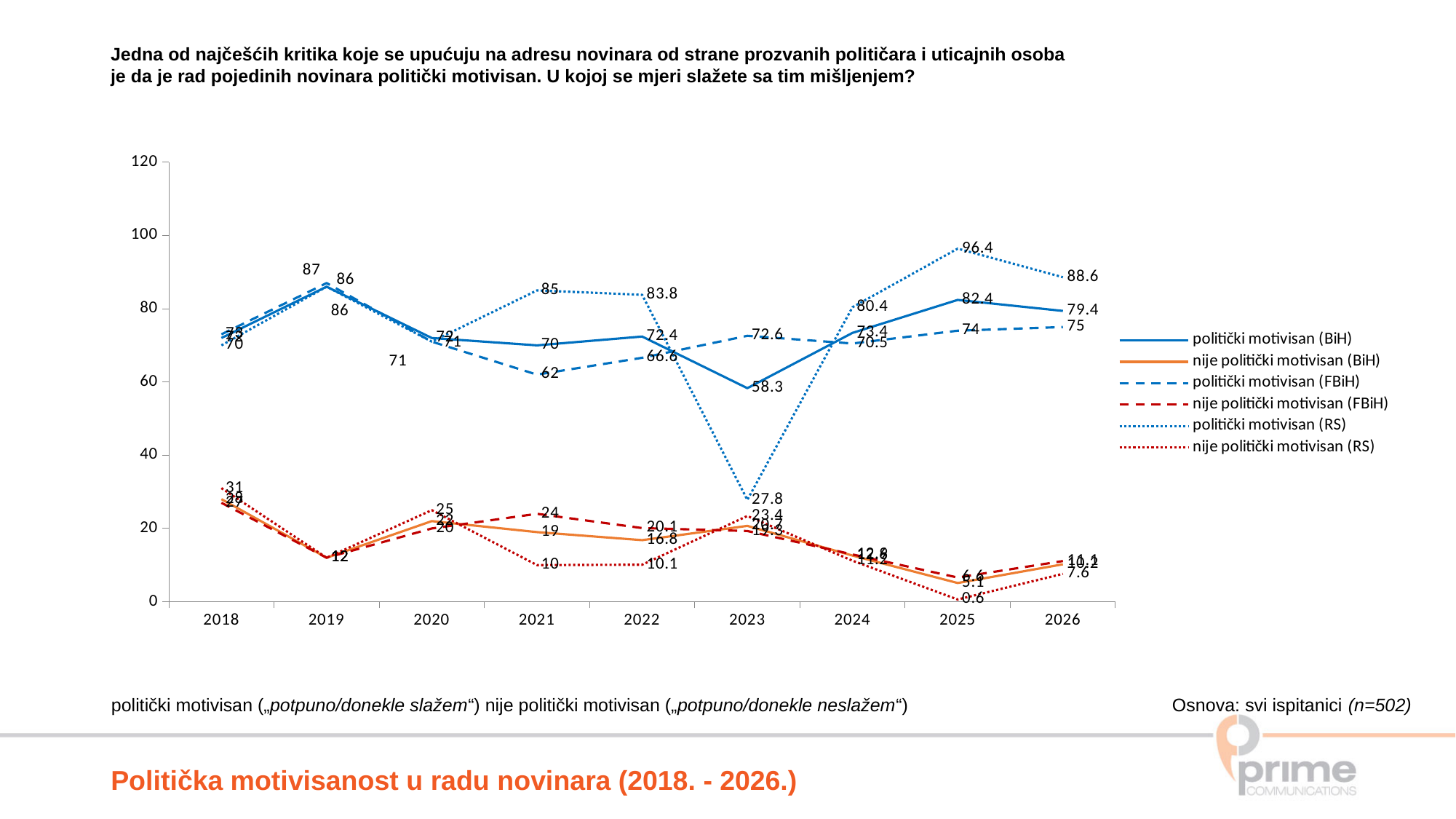
How many years are shown on the x axis? 9 What is the difference between politički motivisan (RS) in 2025 and in 2026? 7.8 What is the value for politički motivisan (RS) in 2025? 96.4 What is the value for politički motivisan (RS) in 2026? 88.6 In which year is politički motivisan (RS) at its highest? 2025 How many series does the legend list? 6 In 2023, which is larger: politički motivisan (BiH) or politički motivisan (FBiH)? politički motivisan (FBiH) What kind of chart is shown on the slide? line chart Does politički motivisan (RS) rise or fall from 2023 to 2025? rise What is the value for nije politički motivisan (RS) in 2025? 0.6 What is the value for politički motivisan (BiH) in 2023? 58.3 In which year is politički motivisan (RS) at its lowest? 2023